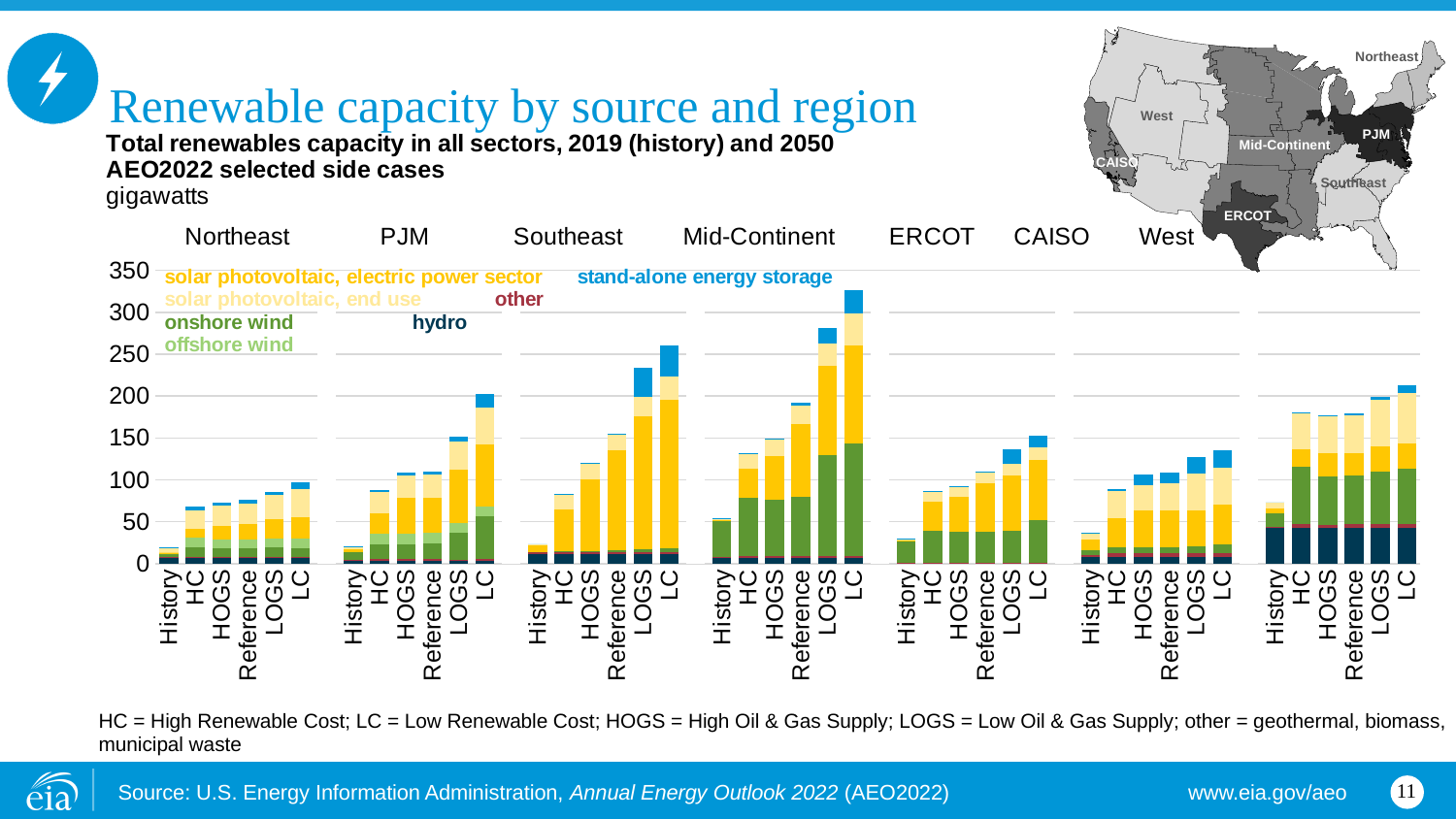
What kind of chart is shown on the slide? Stacked bar chart How many renewable source categories does the legend list? 7 Is the total for the ERCOT LOGS bar greater or less than 100 gigawatts? greater How many bars (cases) are plotted for each region? 6 What unit is the vertical axis of the chart measured in? gigawatts How many regions are shown as separate panels in the chart? 7 Is the total for the Northeast History bar greater or less than 50 gigawatts? less Is the total for the Mid-Continent LC bar greater or less than 300 gigawatts? greater Which is taller, the LC bar for PJM or the LC bar for Southeast? Southeast Which region has the tallest LC (Low Renewable Cost) bar? Mid-Continent In the Southeast panel, do the bar totals rise or fall moving from HC to LC? rise Which region has the shortest LC (Low Renewable Cost) bar? Northeast